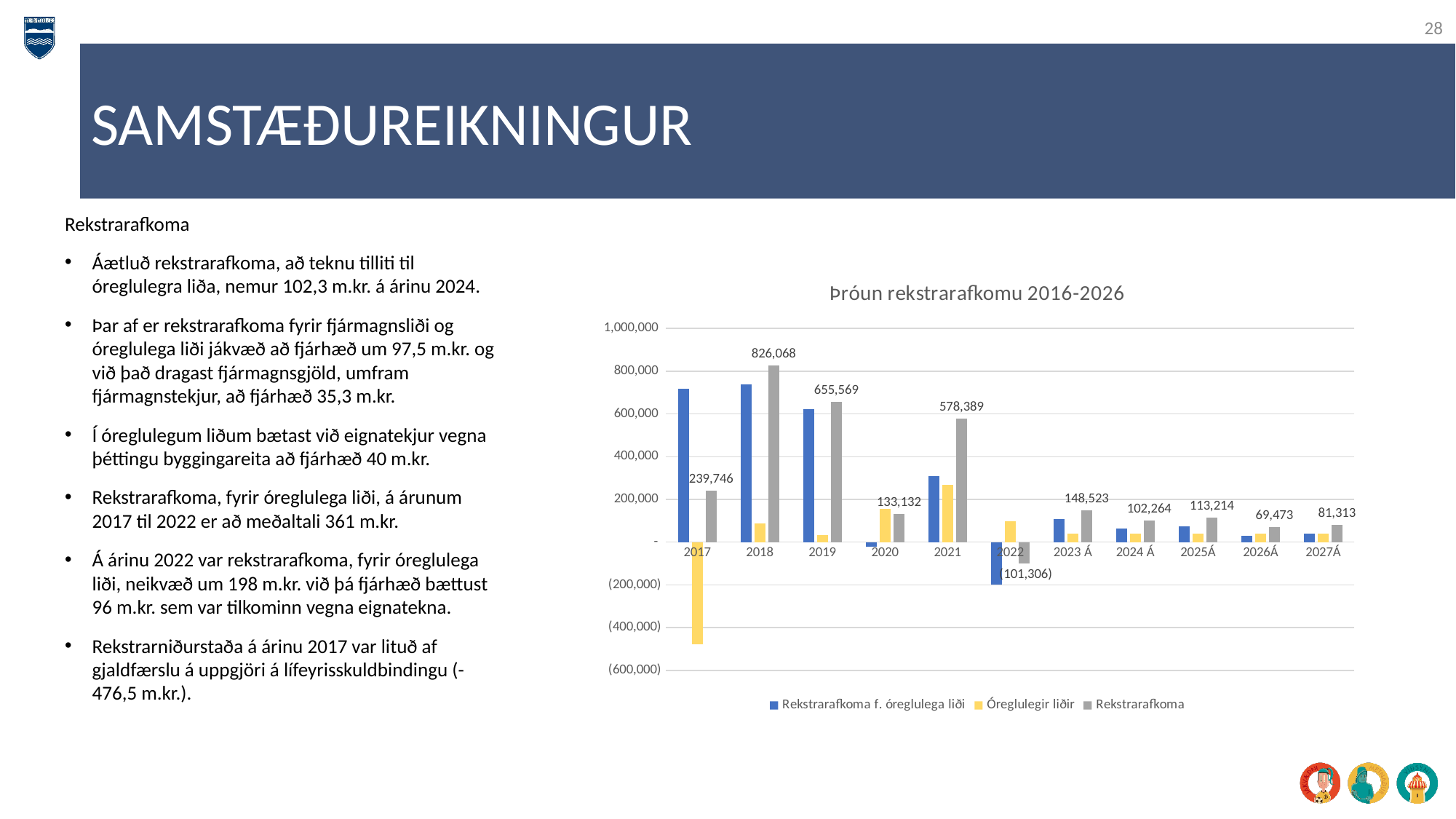
Which is larger, Rekstrarafkoma for 2023 Á or for 2024 Á? 2023 Á In which year is Rekstrarafkoma lowest? 2022 In which year is Rekstrarafkoma highest? 2018 What is the value of Rekstrarafkoma for 2022? (101,306) What kind of chart is shown? bar chart Is the value of Rekstrarafkoma f. óreglulega liði for 2017 greater or less than 600,000? greater How many years are shown on the x axis? 11 What is the difference between Rekstrarafkoma in 2018 and 2019? 170,499 How many series does the legend list? 3 What is the value of Rekstrarafkoma for 2018? 826,068 What is the value of Rekstrarafkoma for 2026Á? 69,473 Is the value of Óreglulegir liðir for 2017 greater or less than (400,000)? less